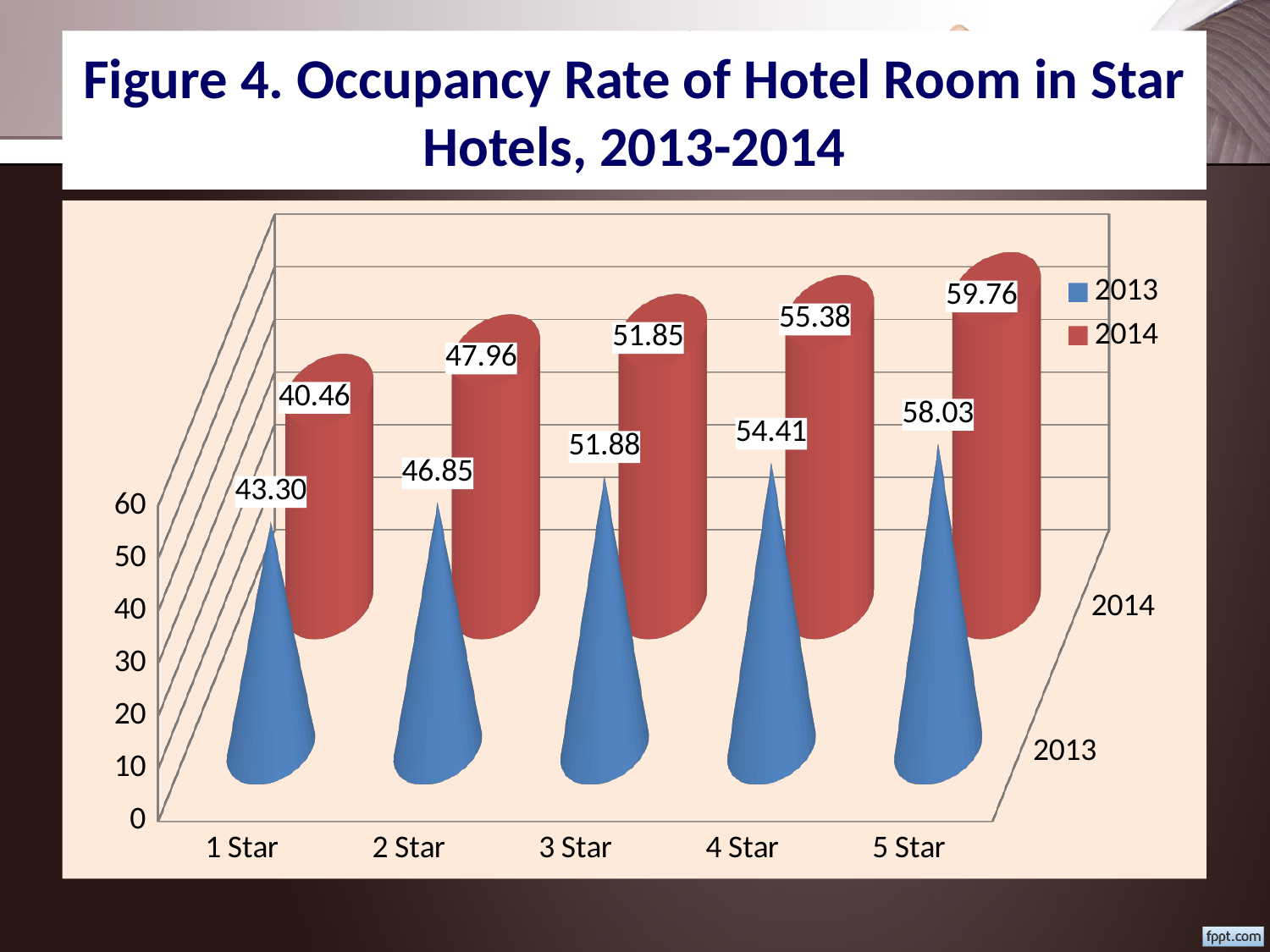
How many star categories are shown on the x axis? 5 What is the difference between the 2014 and 2013 occupancy rates for 5 Star hotels? 1.73 For 4 Star hotels, which year has the higher occupancy rate, 2013 or 2014? 2014 What is the occupancy rate for 1 Star hotels in 2014? 40.46 Which star category has the lowest occupancy rate in 2014? 1 Star How many series does the legend list? 2 For 1 Star hotels, which year has the higher occupancy rate, 2013 or 2014? 2013 Which star category has the highest occupancy rate in 2013? 5 Star What is the occupancy rate for 3 Star hotels in 2013? 51.88 What is the difference between the 2013 occupancy rates of 4 Star and 1 Star hotels? 11.11 Do the 2014 occupancy rates rise or fall from 1 Star to 5 Star? rise What is the occupancy rate for 5 Star hotels in 2014? 59.76